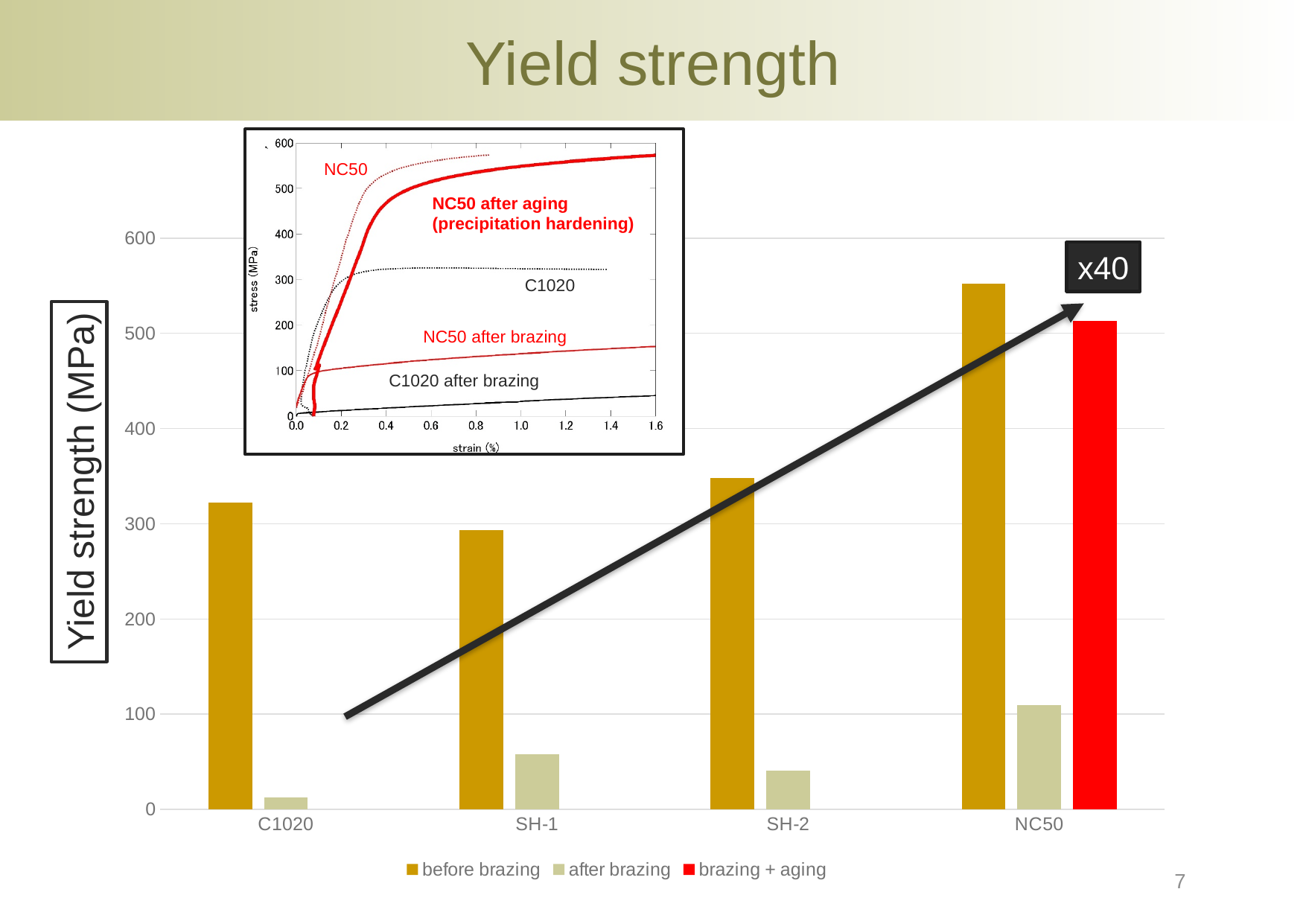
How many series does the legend of the main bar chart list? 3 What kind of chart is the inset chart at the top of the slide? line chart In the main bar chart, is the 'brazing + aging' value for NC50 greater or less than 400? greater In the main bar chart, which category has the lowest 'after brazing' value? C1020 In the main bar chart, which category has the highest 'before brazing' value? NC50 In the main bar chart, is the 'after brazing' value for NC50 greater or less than 200? less In the main bar chart, which is larger for SH-2: the 'before brazing' value or the 'after brazing' value? before brazing In the main bar chart, is the 'before brazing' value for SH-1 greater or less than 200? greater How many categories are shown on the x axis of the main bar chart? 4 In the main bar chart, which category has the larger 'after brazing' value, SH-1 or C1020? SH-1 In the main bar chart, which category is the only one with a 'brazing + aging' bar? NC50